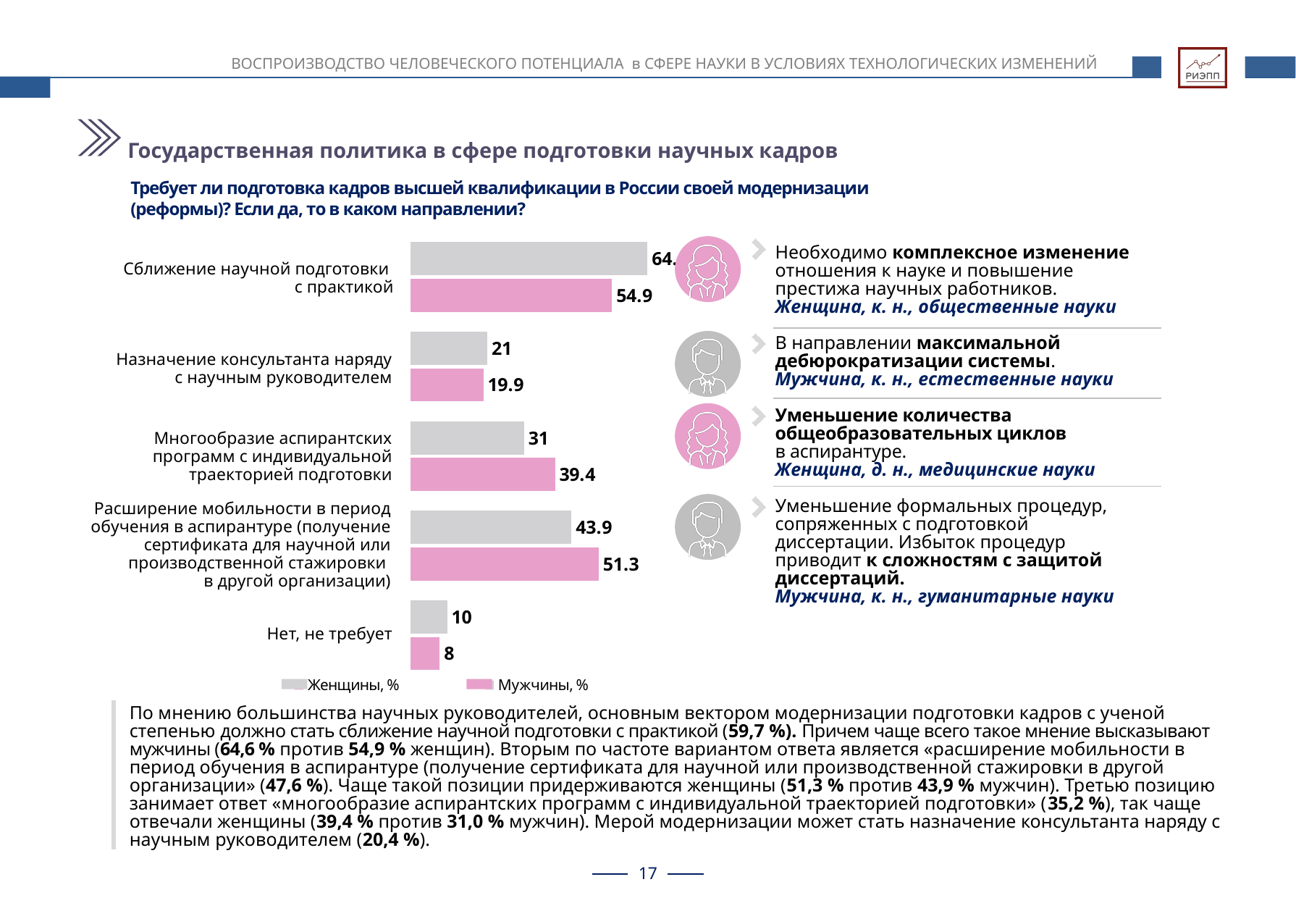
Which category has the lowest value for 'Мужчины, %'? Нет, не требует What is the value for 'Женщины, %' for 'Назначение консультанта наряду с научным руководителем'? 21 How many answer categories are shown in the chart? 5 What is the value for 'Мужчины, %' for 'Многообразие аспирантских программ с индивидуальной траекторией подготовки'? 39.4 What is the value for 'Мужчины, %' for 'Сближение научной подготовки с практикой'? 54.9 What is the value for 'Женщины, %' for 'Расширение мобильности в период обучения в аспирантуре'? 43.9 Which category has the highest value for 'Мужчины, %'? Сближение научной подготовки с практикой What is the difference between 'Мужчины, %' and 'Женщины, %' for 'Расширение мобильности в период обучения в аспирантуре'? 7.4 What kind of chart is shown on the slide? bar chart For 'Многообразие аспирантских программ с индивидуальной траекторией подготовки', which series has the larger value, 'Женщины, %' or 'Мужчины, %'? Мужчины, % How many series does the chart legend list? 2 What is the value for 'Мужчины, %' for 'Нет, не требует'? 8